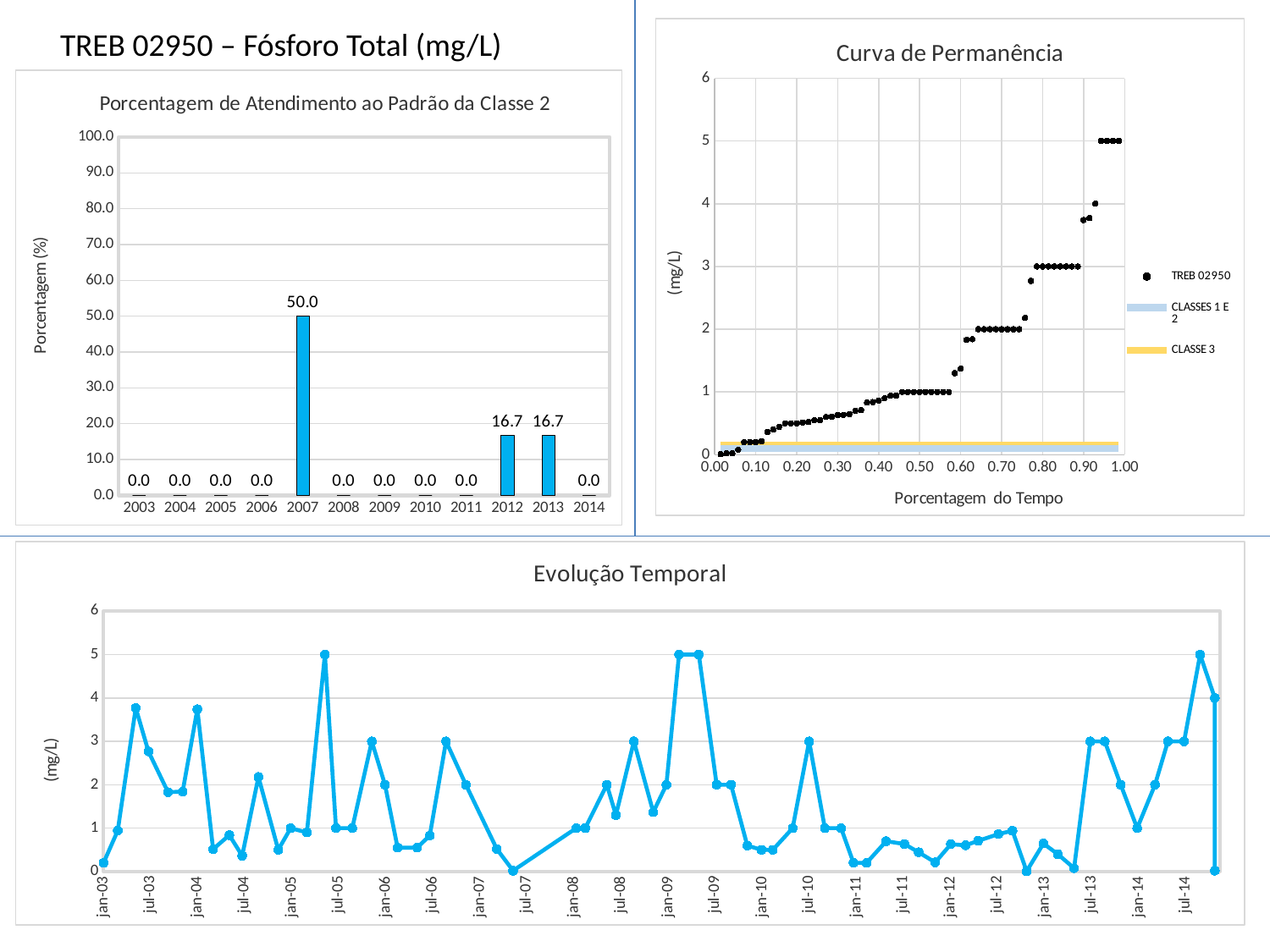
What is the x-axis title of the chart 'Curva de Permanência'? Porcentagem do Tempo In the chart 'Porcentagem de Atendimento ao Padrão da Classe 2', what is the value for 2007? 50.0 In the chart 'Curva de Permanência', do the plotted values rise or fall as the x axis increases? Rise What kind of chart is 'Porcentagem de Atendimento ao Padrão da Classe 2'? Bar chart In the chart 'Porcentagem de Atendimento ao Padrão da Classe 2', what is the value for 2009? 0.0 In the chart 'Porcentagem de Atendimento ao Padrão da Classe 2', which year has the highest value? 2007 In the chart 'Porcentagem de Atendimento ao Padrão da Classe 2', what is the value for 2012? 16.7 In the chart 'Porcentagem de Atendimento ao Padrão da Classe 2', is the value for 2007 larger than the value for 2012? Yes, 2007 How many entries does the legend of the chart 'Curva de Permanência' list? 3 In the chart 'Porcentagem de Atendimento ao Padrão da Classe 2', what is the difference between the values for 2007 and 2013? 33.3 In the chart 'Evolução Temporal', is the highest plotted value greater or less than 4? greater In the chart 'Porcentagem de Atendimento ao Padrão da Classe 2', how many years are shown on the x axis? 12